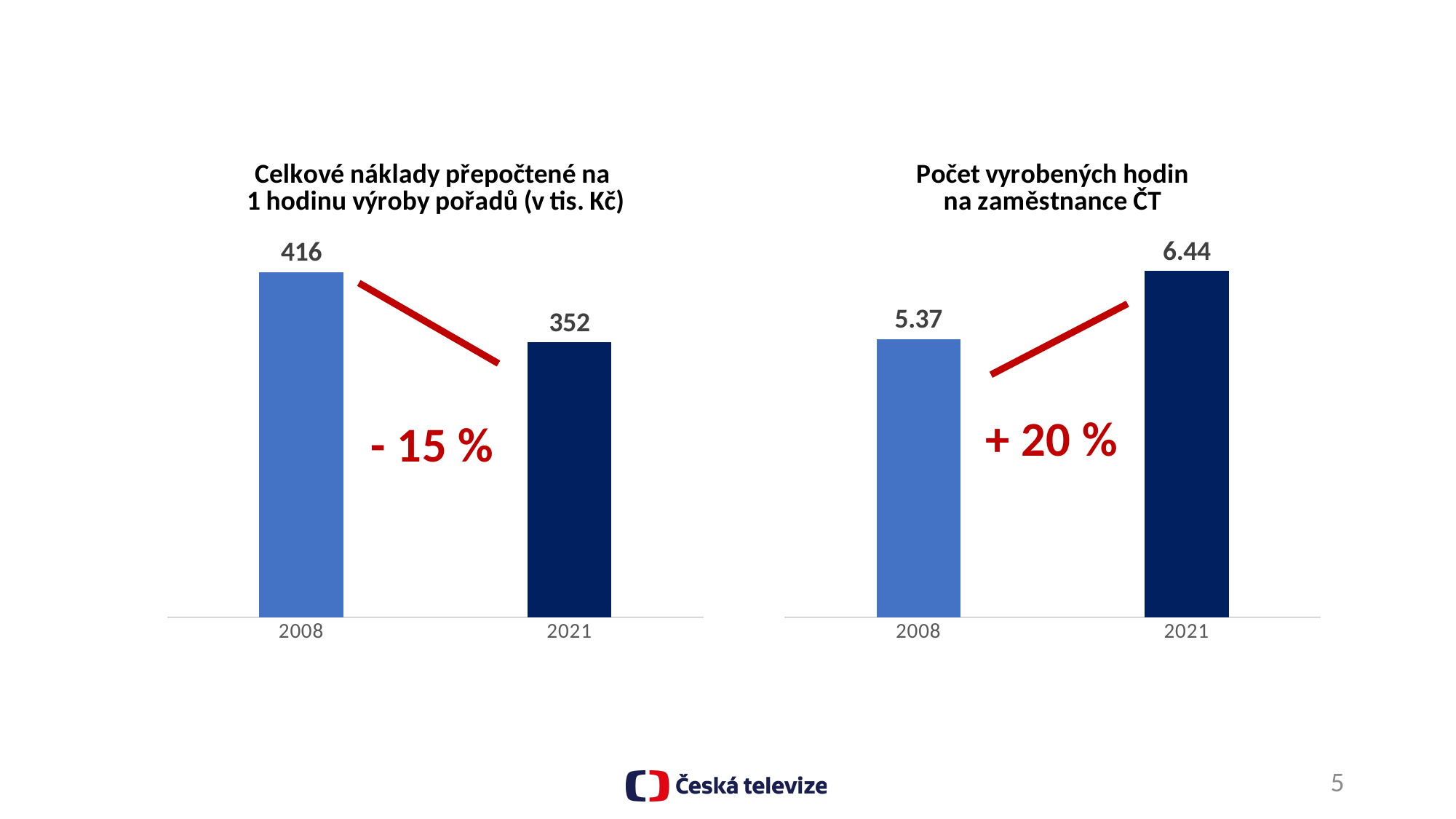
In the right chart, which year has the lower value? 2008 What kind of chart is the left chart? bar chart In the right chart, what is the difference between the 2021 and 2008 values? 1.07 How many categories (years) does the right chart show? 2 In the left chart, which year has the higher value? 2008 In the left chart (Celkové náklady přepočtené na 1 hodinu výroby pořadů), what is the value for 2021? 352 In the left chart (Celkové náklady přepočtené na 1 hodinu výroby pořadů), what is the value for 2008? 416 In the right chart, is the value for 2021 larger or smaller than the value for 2008? larger In the right chart (Počet vyrobených hodin na zaměstnance ČT), what is the value for 2008? 5.37 In the right chart (Počet vyrobených hodin na zaměstnance ČT), what is the value for 2021? 6.44 In the left chart, do the values rise or fall from 2008 to 2021? fall In the left chart, what is the difference between the 2008 and 2021 values? 64